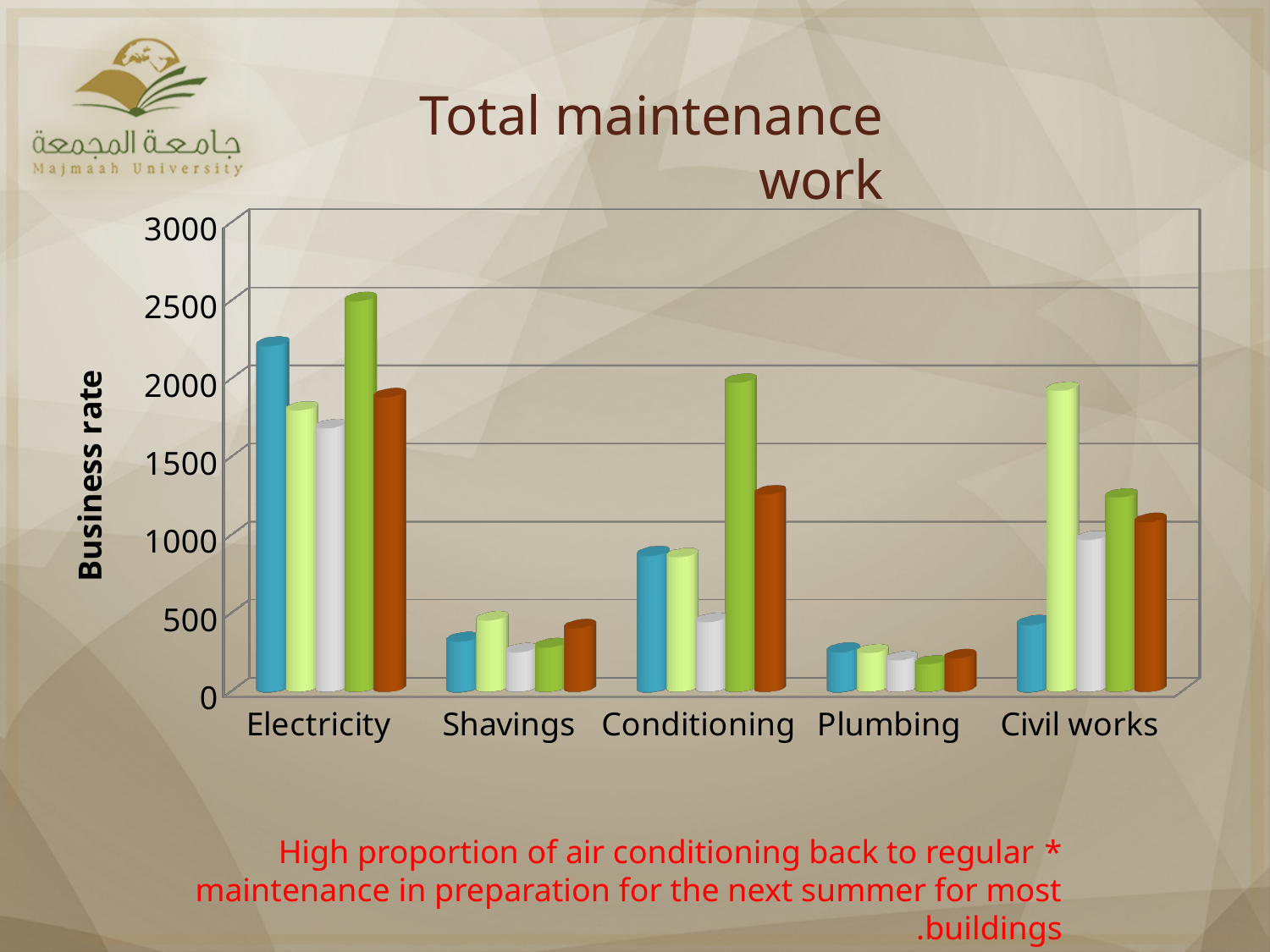
How many bars are plotted for each category in the chart? 5 What kind of chart is shown on the slide? Bar chart What is the label on the vertical axis of the chart? Business rate Is the value of the blue bar for Electricity greater or less than 2000? greater Which is larger, the blue bar for Electricity or the blue bar for Civil works? Electricity How many categories are shown along the x axis of the chart? 5 Is the value of the brown bar for Conditioning greater or less than 1000? greater Which category has the lowest bars overall in the chart? Plumbing What is the title of the chart? Total maintenance work Is the value of the blue bar for Conditioning greater or less than 1000? less Which category contains the tallest bar in the chart? Electricity